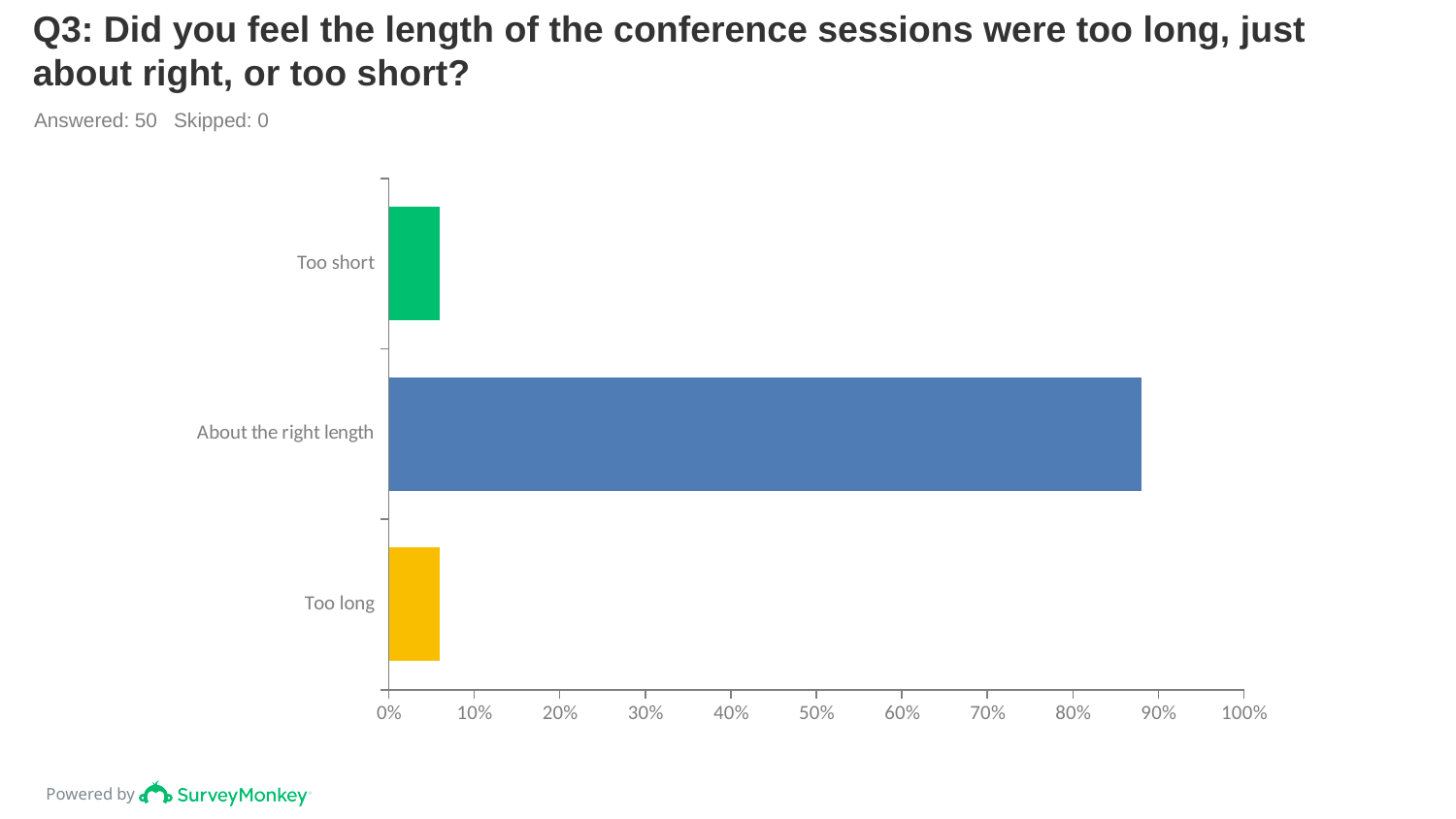
Is the value for "Too long" greater or less than 10%? less What colour is the bar for "About the right length"? Blue Is the value for "About the right length" greater or less than 90%? less Which is larger, the value for "About the right length" or the value for "Too long"? About the right length Is the value for "About the right length" greater or less than 80%? greater How many response categories are shown in the chart? 3 Which response category has the highest value? About the right length Which is larger, the value for "Too short" or the value for "About the right length"? About the right length How many respondents answered this question according to the slide? 50 What kind of chart is shown on the slide? Bar chart